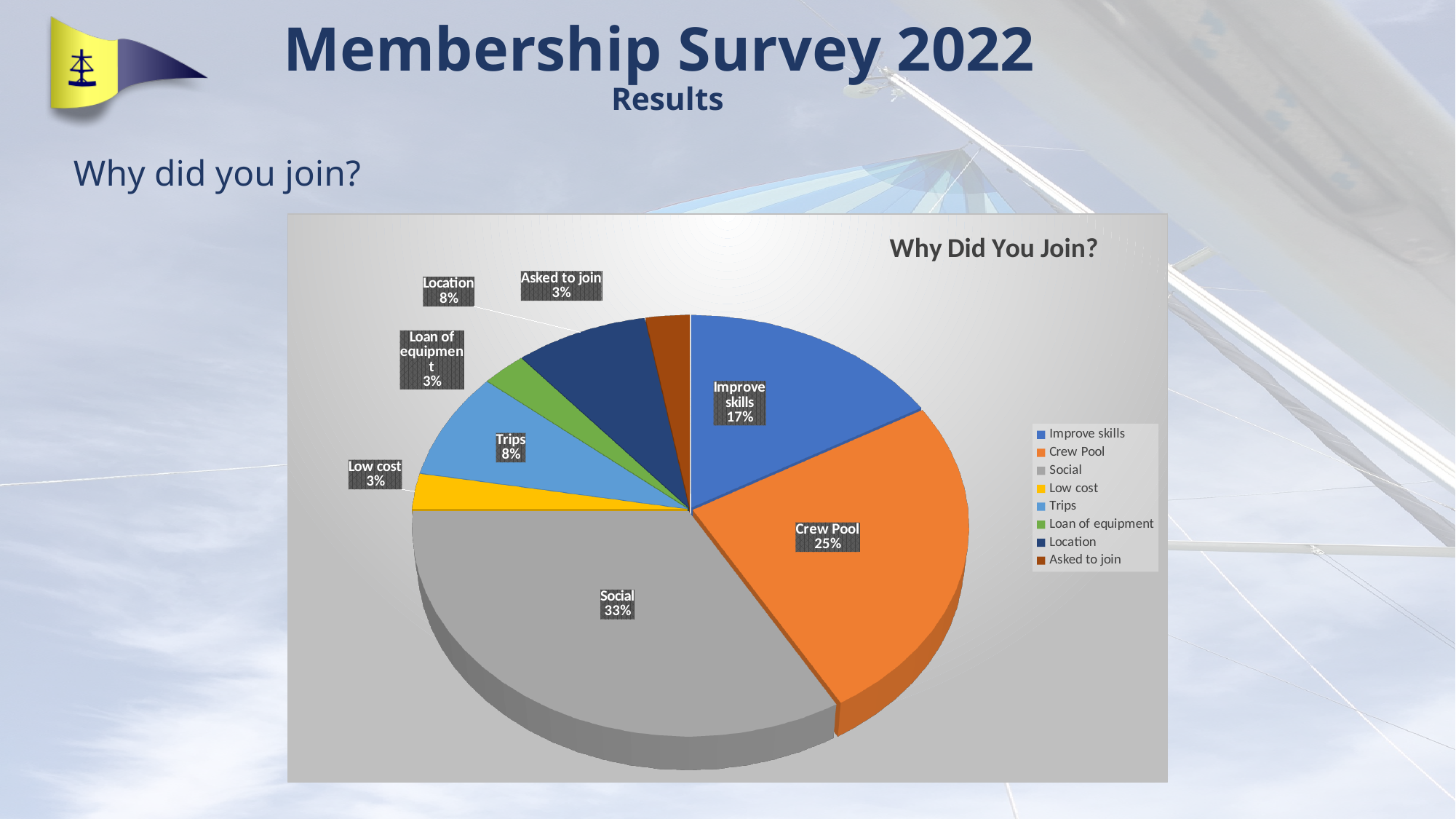
What percentage of the pie is Crew Pool? 25% What type of chart is shown on the slide? Pie chart What percentage of the pie is Social? 33% What is the title of the chart? Why Did You Join? What is the difference in percentage points between Social and Crew Pool? 8 Which category has the largest share of the pie? Social What percentage of the pie is Trips? 8% What percentage of the pie is Asked to join? 3% What percentage of the pie is Improve skills? 17% Which is larger, Improve skills or Location? Improve skills How many categories does the legend list? 8 What colour is the Crew Pool slice? Orange